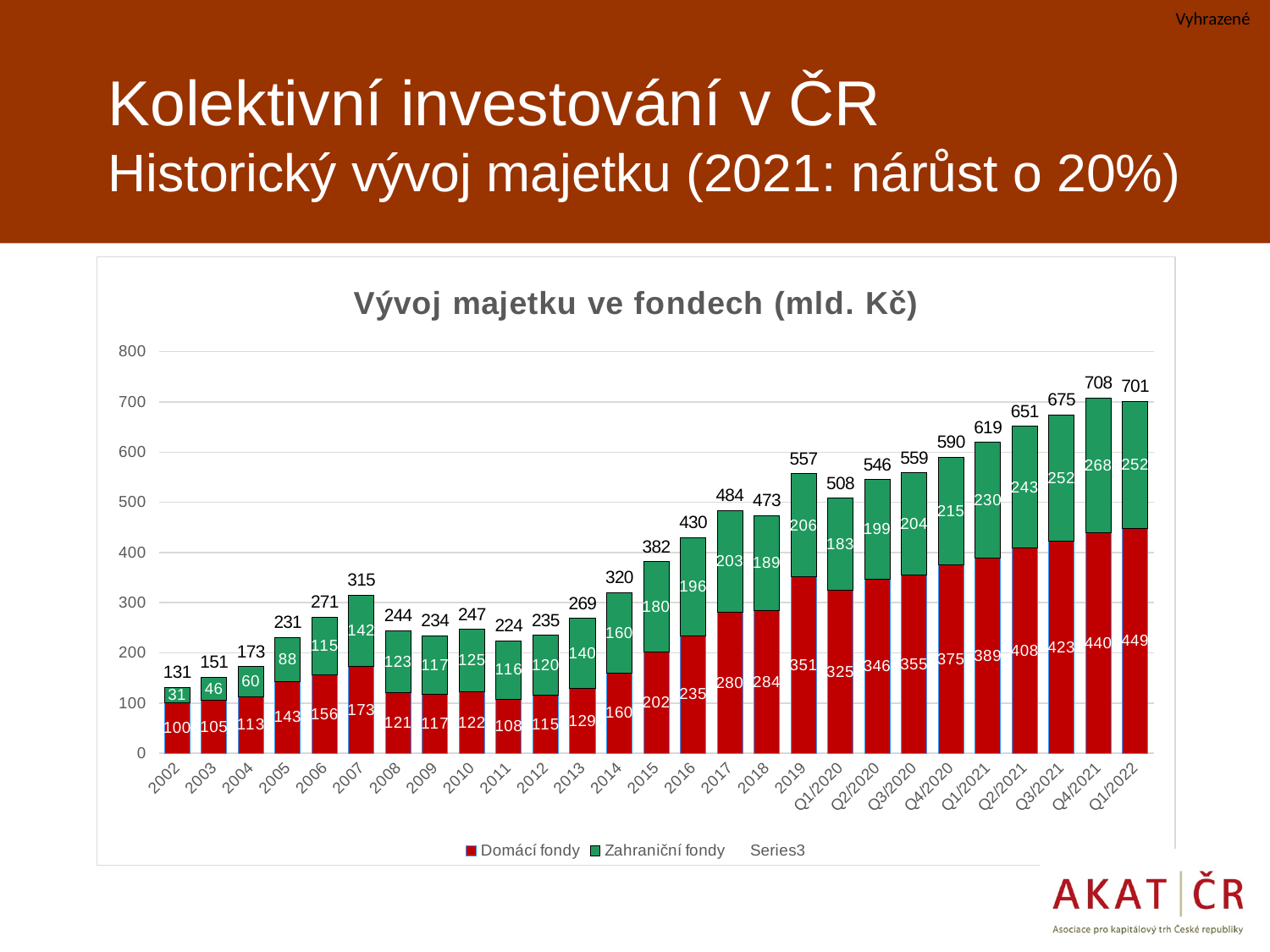
Is the total value for 2014 greater or less than 300? greater Which is larger, the Domácí fondy value for 2015 or the Zahraniční fondy value for 2015? Domácí fondy (202) Which category has the highest total value? Q4/2021 How many categories are shown on the x axis? 27 What is the value of Zahraniční fondy for Q4/2021? 268 What kind of chart is shown on the slide? Stacked bar chart What is the title of the chart? Vývoj majetku ve fondech (mld. Kč) What is the difference between the total for 2019 and the total for 2018? 84 What is the value of Domácí fondy for 2007? 173 What is the total of the stacked bar for Q1/2022? 701 Which category has the lowest total value? 2002 How many series does the legend list? 3